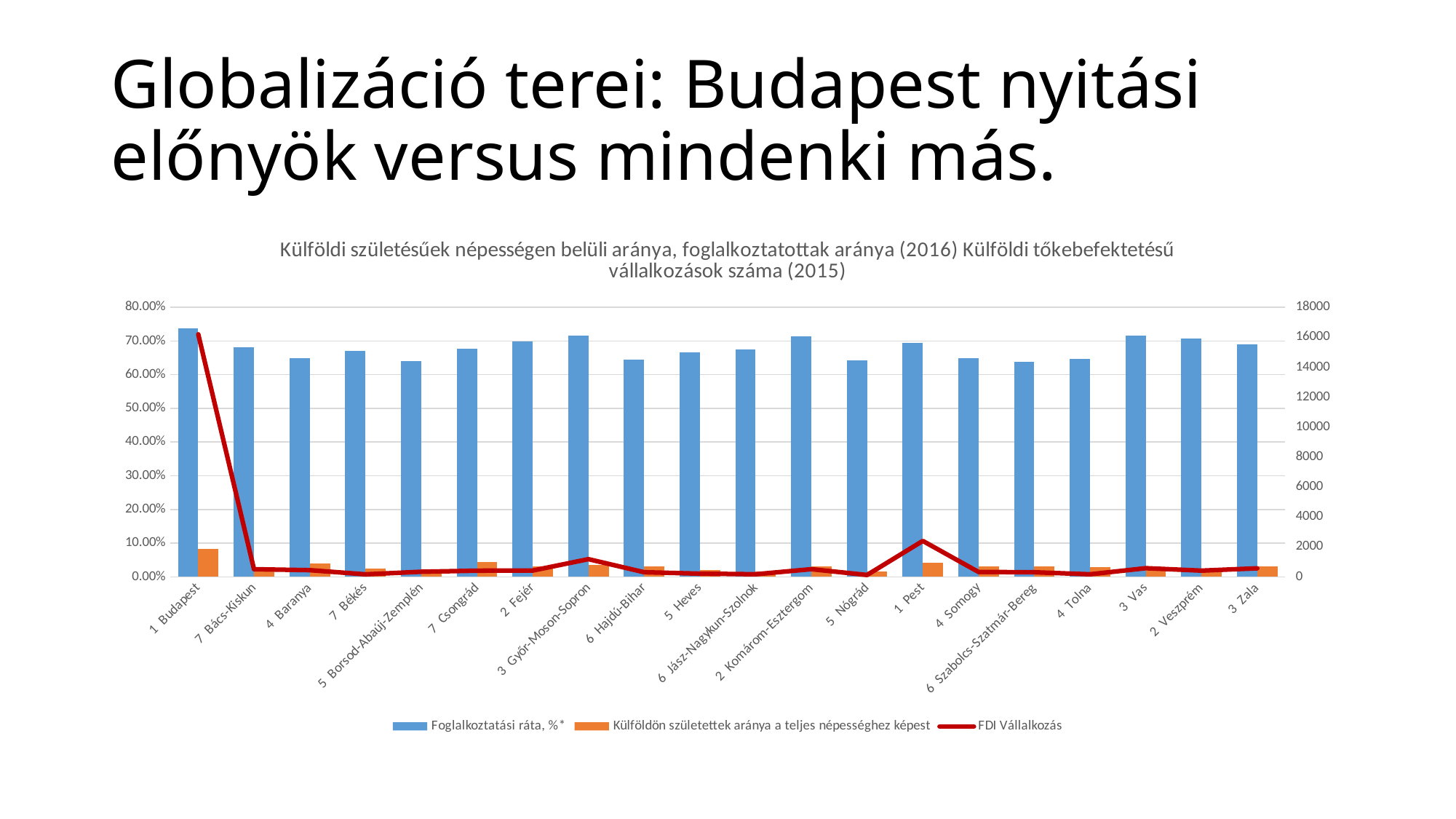
Is the FDI Vállalkozás value for 1 Pest greater or less than 4000? less Which category has the highest Foglalkoztatási ráta, %* (blue bar)? 1 Budapest How many counties/categories are shown on the x axis of the chart? 20 Is the FDI Vállalkozás value for 1 Budapest greater or less than 14000? greater Which series is drawn as a red line in the chart? FDI Vállalkozás What kind of chart is shown on the slide? A combined bar and line chart How many series does the chart's legend list? 3 Which category has the highest value on the FDI Vállalkozás line? 1 Budapest Which has the larger Foglalkoztatási ráta, %*: 3 Győr-Moson-Sopron or 5 Nógrád? 3 Győr-Moson-Sopron Is the Külföldön születettek aránya value for 1 Budapest greater or less than 10.00%? less Which category has the highest Külföldön születettek aránya a teljes népességhez képest (orange bar)? 1 Budapest